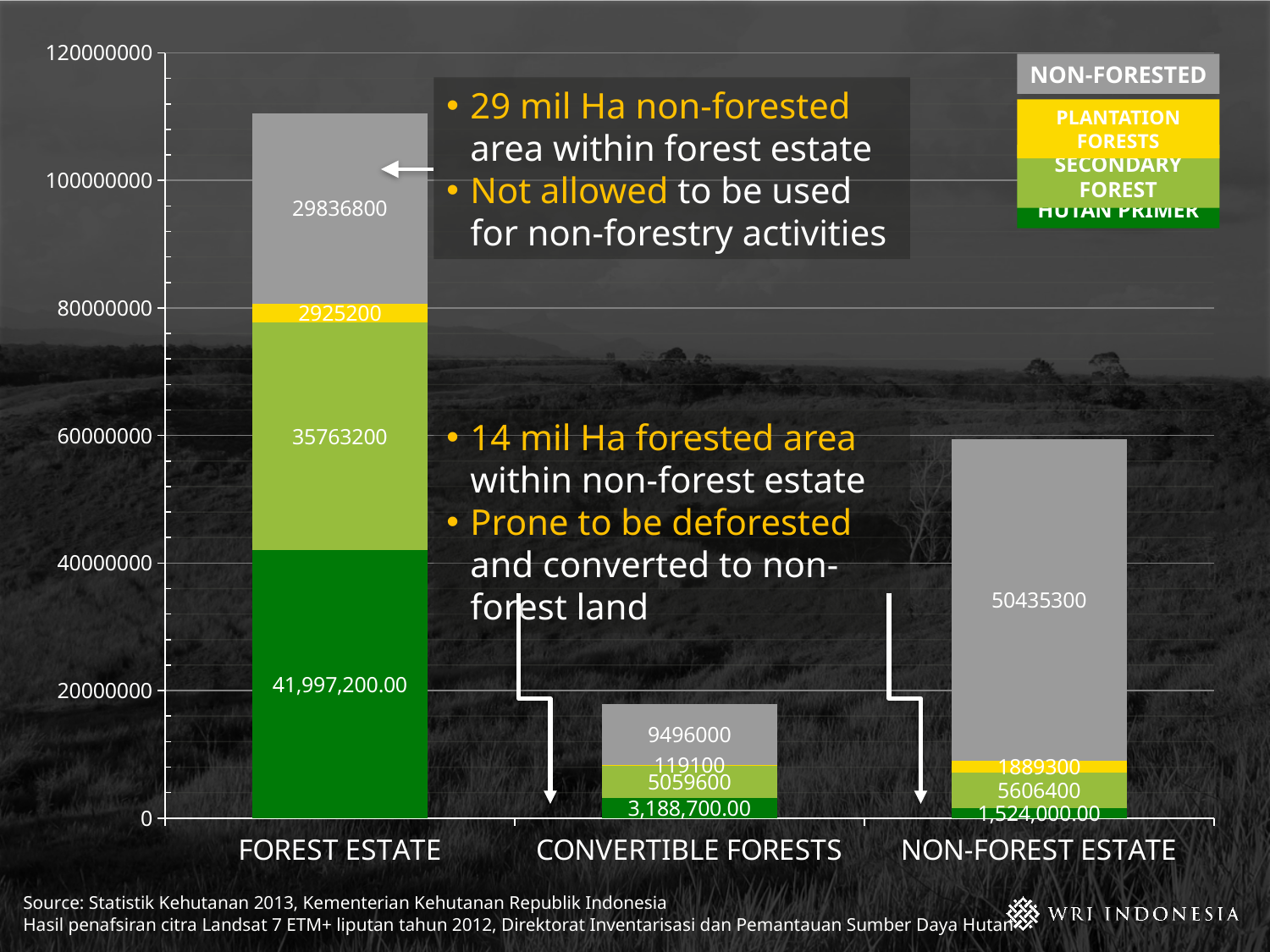
What is the NON-FORESTED value for FOREST ESTATE? 29836800 What is the SECONDARY FOREST value for CONVERTIBLE FORESTS? 5059600 Which category has the tallest stacked bar? FOREST ESTATE Which category has the shortest stacked bar? CONVERTIBLE FORESTS Which is larger: the SECONDARY FOREST value for FOREST ESTATE or the NON-FORESTED value for FOREST ESTATE? SECONDARY FOREST What is the HUTAN PRIMER value for FOREST ESTATE? 41,997,200.00 What is the NON-FORESTED value for NON-FOREST ESTATE? 50435300 How many categories are shown on the x axis of the chart? 3 How many series does the chart legend list? 4 What type of chart is shown on the slide? Stacked bar chart What is the difference between the NON-FORESTED values for NON-FOREST ESTATE and FOREST ESTATE? 20598500 Is the total stacked bar for NON-FOREST ESTATE greater or less than 40000000? greater